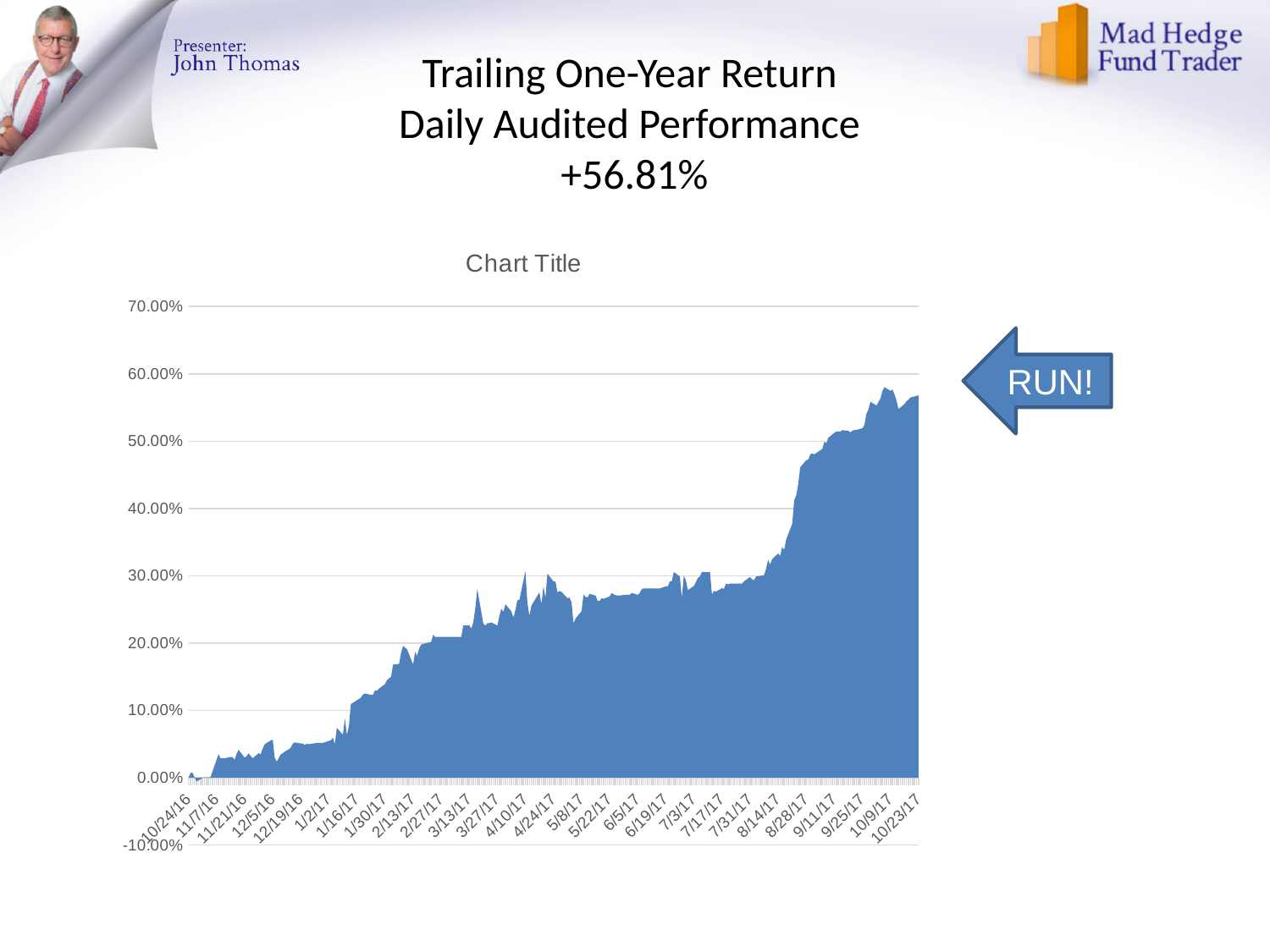
Do the values generally rise or fall from 10/24/16 to 10/23/17? rise Is the value at 5/8/17 greater or less than 20.00%? greater Is the highest value reached on the chart greater or less than 60.00%? less Which is larger, the value at 6/5/17 or the value at 1/2/17? 6/5/17 Is the value at 11/21/16 greater or less than 10.00%? less What kind of chart is shown on the slide? area chart What trailing one-year return figure is stated in the slide heading? +56.81% What is the title printed above the chart? Chart Title Which is larger, the value at 10/23/17 or the value at 10/24/16? 10/23/17